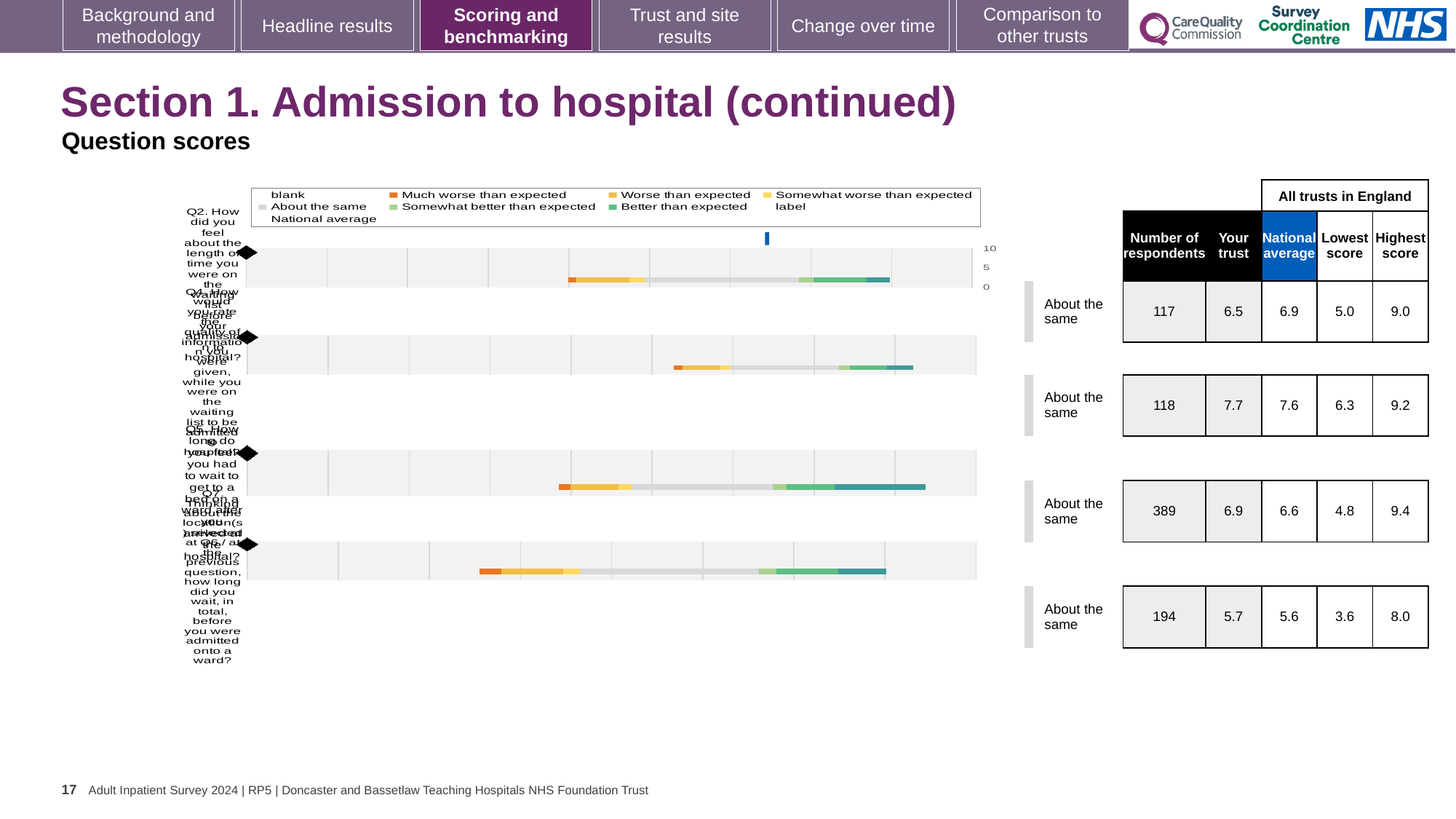
What kind of chart is shown on the slide? bar chart Which question row has the highest 'Your trust' score? the second row (7.7) What benchmark category is shown for every question row on the slide? About the same What is the difference between the highest score and the lowest score for the third question row? 4.6 What is the heading above the 'Lowest score' and 'Highest score' columns in the table? All trusts in England What is the 'Your trust' score for the first (top) question row? 6.5 Which question row has the lowest 'Your trust' score? the fourth row (5.7) How many respondents are listed for the third question row? 389 What is the national average for the second question row? 7.6 For the first question row, is the 'Your trust' score or the national average larger? national average How many question rows (bars) are plotted in the chart? 4 What is the highest score across all trusts in England for the fourth (bottom) question row? 8.0